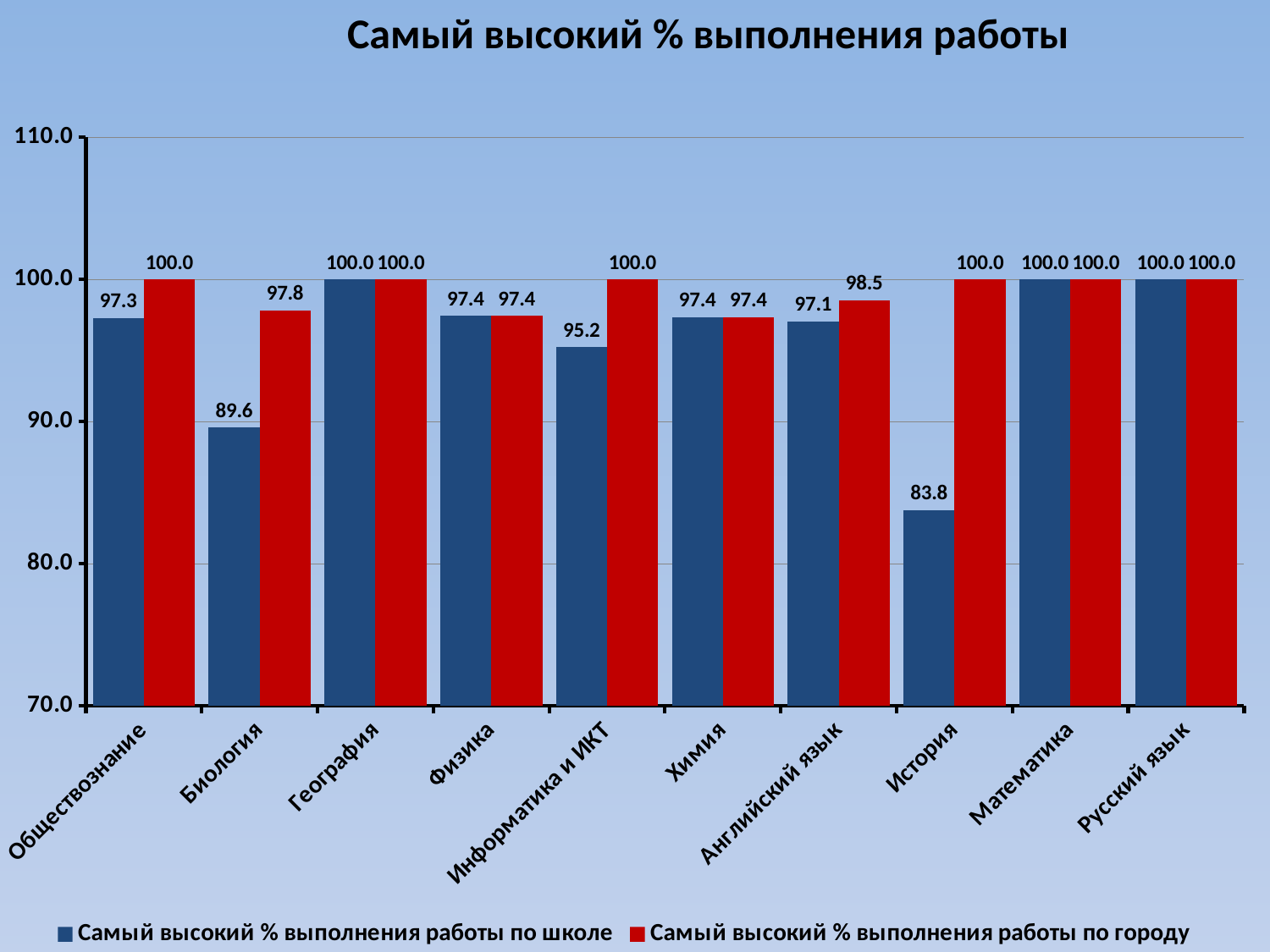
What is the difference between the city value and the school value for История? 16.2 How many series does the legend list? 2 What kind of chart is shown on the slide? bar chart What is the value for Английский язык in the series 'Самый высокий % выполнения работы по городу'? 98.5 For Информатика и ИКТ, which is larger: the school value or the city value? the city value What is the value for Биология in the series 'Самый высокий % выполнения работы по школе'? 89.6 Which category has the lowest value in the series 'Самый высокий % выполнения работы по городу'? Физика and Химия (97.4) How many categories are shown on the x axis? 10 Which category has the lowest value in the series 'Самый высокий % выполнения работы по школе'? История What is the value for История in the series 'Самый высокий % выполнения работы по городу'? 100.0 What is the title of the chart? Самый высокий % выполнения работы What is the difference between the city value and the school value for Биология? 8.2